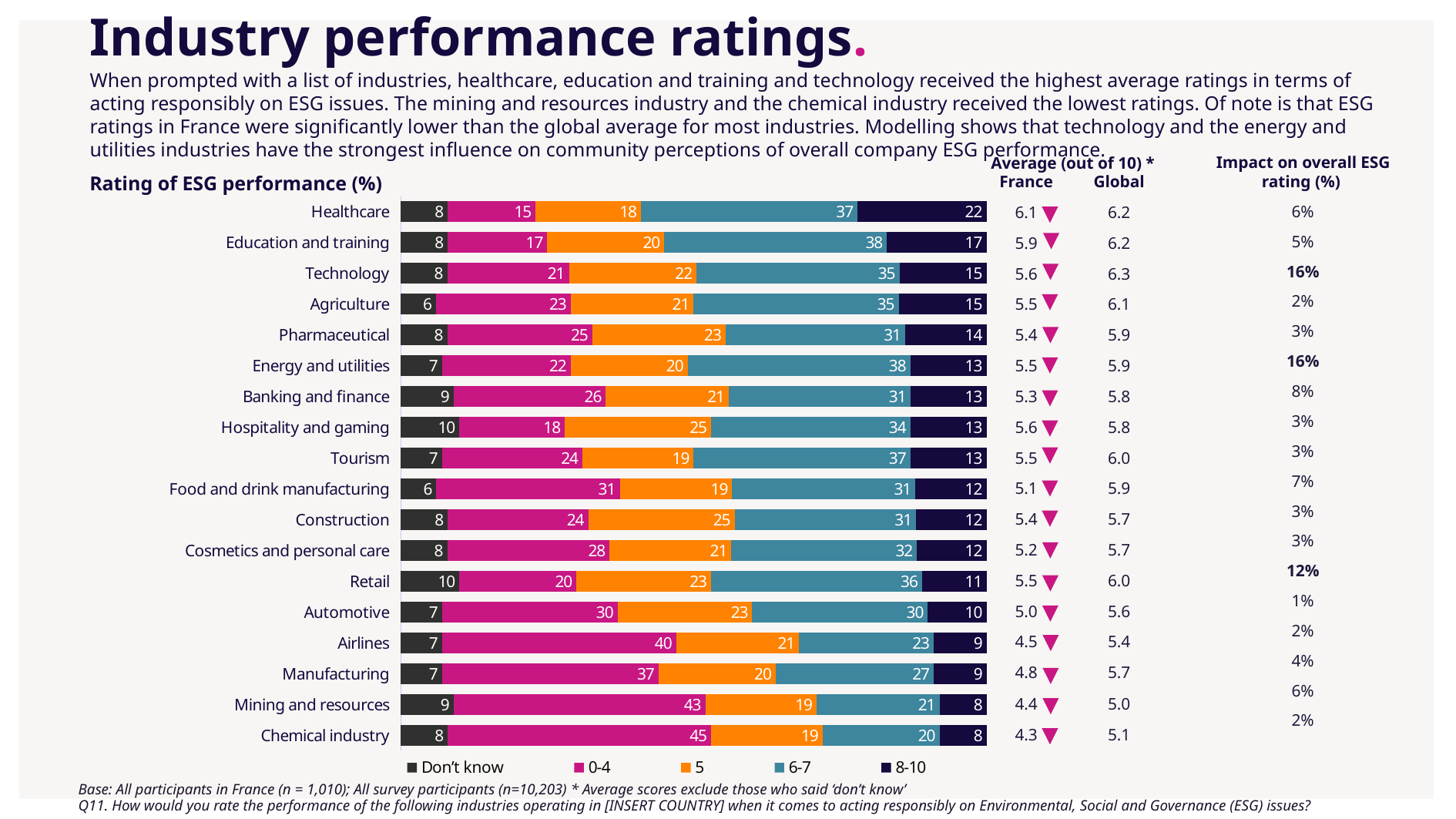
What type of chart is used to show the rating of ESG performance? Stacked bar chart How many series does the legend list? 5 Which has a larger 0-4 share, Airlines or Manufacturing? Airlines Which industry has the highest share of 0-4 ratings? Chemical industry Which industry has the highest share of 8-10 ratings? Healthcare How many industries are shown in the chart? 18 Which industry has the lowest share of 0-4 ratings? Healthcare What percentage of respondents rated the Chemical industry 0-4? 45 What is the total of the segments in the Healthcare bar? 100 What is the difference between the 6-7 share for Education and training and the 6-7 share for the Chemical industry? 18 What percentage of respondents rated Healthcare 8-10? 22 What is the value of the '5' segment for Hospitality and gaming? 25